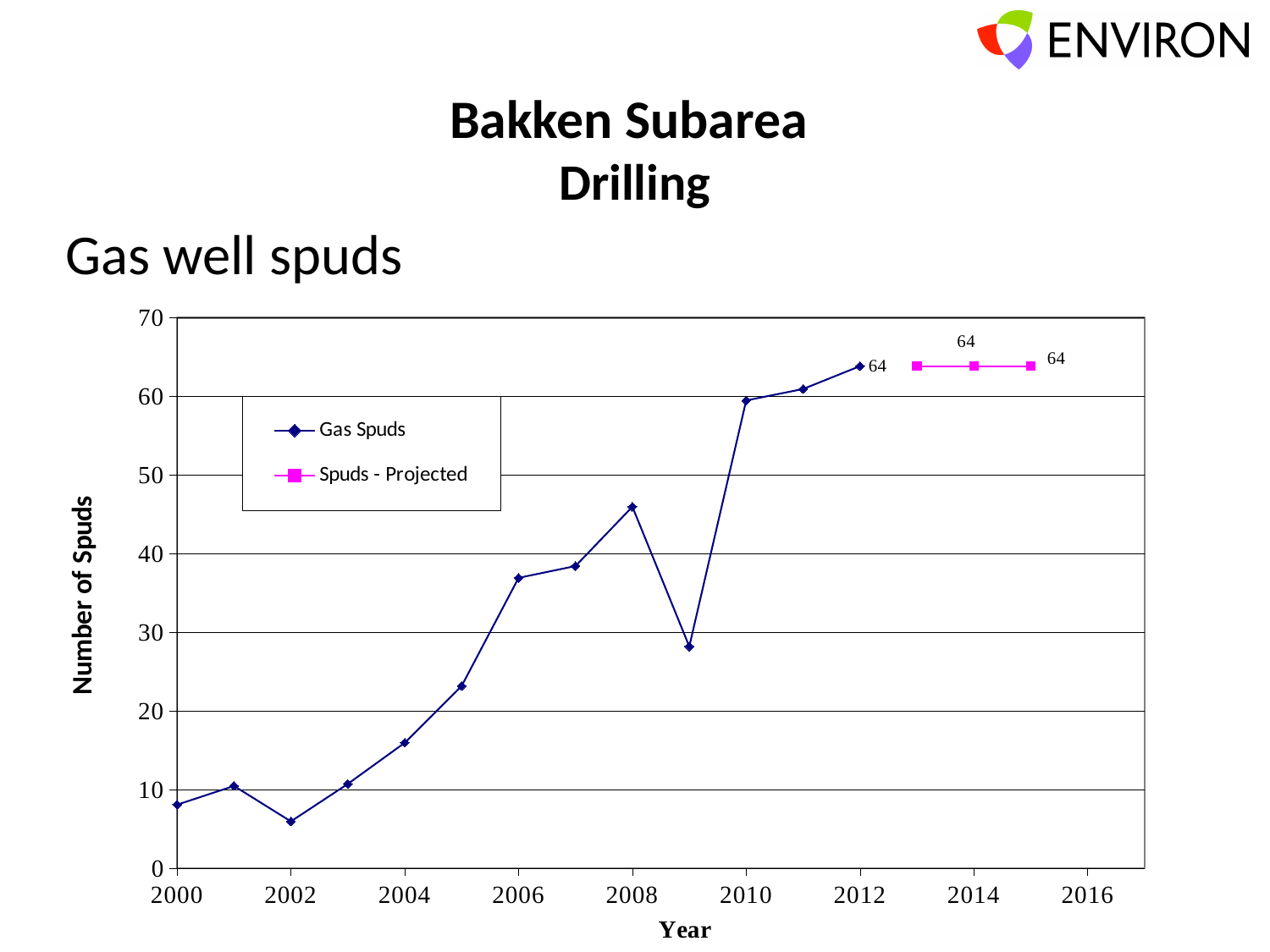
In which year is the Gas Spuds series at its lowest? 2002 What is the projected number of spuds for 2014? 64 Is the Gas Spuds value for 2009 greater or less than 30? less How many data points does the Spuds - Projected series have? 3 What is the title of the y axis? Number of Spuds Is the Gas Spuds value for 2002 greater or less than 10? less What is the projected number of spuds for 2015? 64 Which year has more Gas Spuds, 2008 or 2009? 2008 What kind of chart is shown? Line chart How many series does the legend list? 2 What is the value of Gas Spuds in 2012? 64 Is the Gas Spuds value for 2008 greater or less than 40? greater